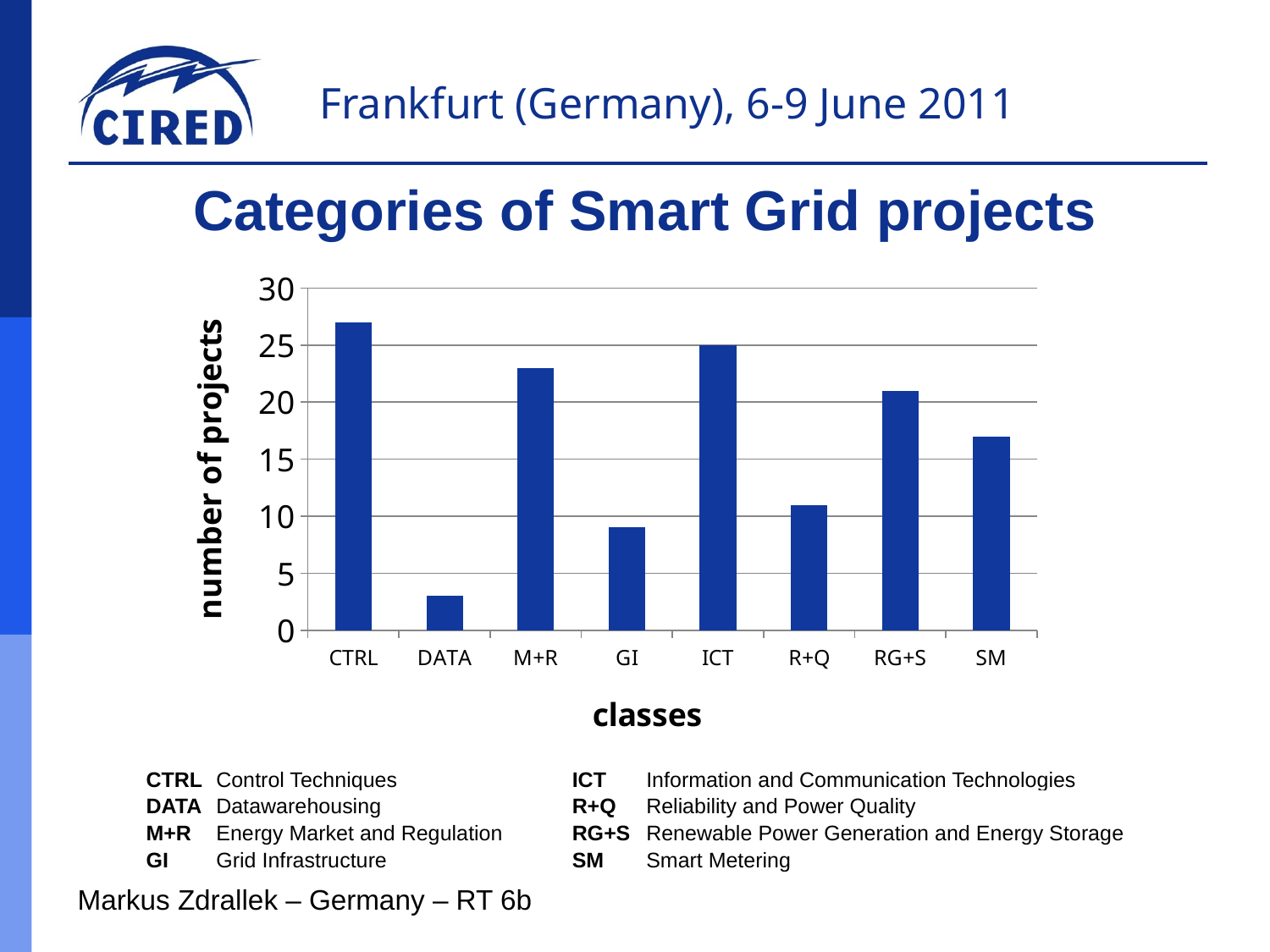
Which class has the highest number of projects? CTRL Is the number of projects for CTRL greater or less than 25? greater Which has more projects, M+R or SM? M+R Which has more projects, R+Q or GI? R+Q How many classes are plotted on the x axis of the chart? 8 What is the label of the y axis of the chart? number of projects Which class has the lowest number of projects? DATA What is the label of the x axis of the chart? classes Is the number of projects for DATA greater or less than 5? less What kind of chart is shown on the slide? bar chart Is the number of projects for GI greater or less than 10? less